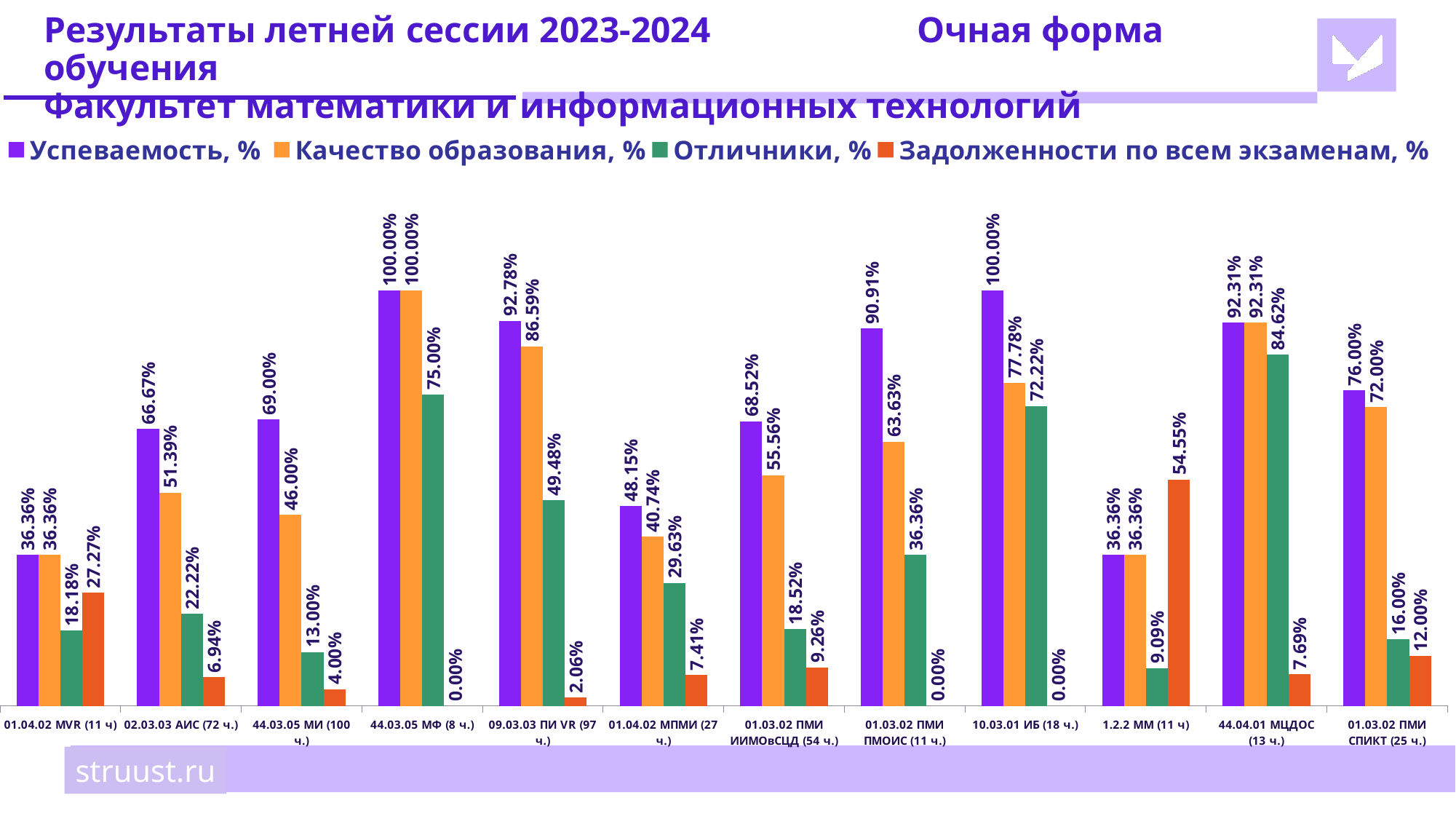
Which category has the highest value of Задолженности по всем экзаменам, %? 1.2.2 ММ (11 ч) What is the difference between Успеваемость, % and Качество образования, % for 10.03.01 ИБ (18 ч.)? 22.22% Which category has the highest value of Отличники, %? 44.04.01 МЦДОС (13 ч.) How many series does the legend list? 4 What is the value of Успеваемость, % for 01.03.02 ПМИ ПМОИС (11 ч.)? 90.91% Which category has the lowest value of Отличники, %? 1.2.2 ММ (11 ч) What is the value of Отличники, % for 10.03.01 ИБ (18 ч.)? 72.22% What kind of chart is shown on the slide? Bar chart Which is larger for 01.04.02 МПМИ (27 ч.): Отличники, % or Задолженности по всем экзаменам, %? Отличники, % What is the value of Качество образования, % for 09.03.03 ПИ VR (97 ч.)? 86.59% How many categories are shown on the x axis? 12 What is the value of Задолженности по всем экзаменам, % for 01.04.02 MVR (11 ч)? 27.27%